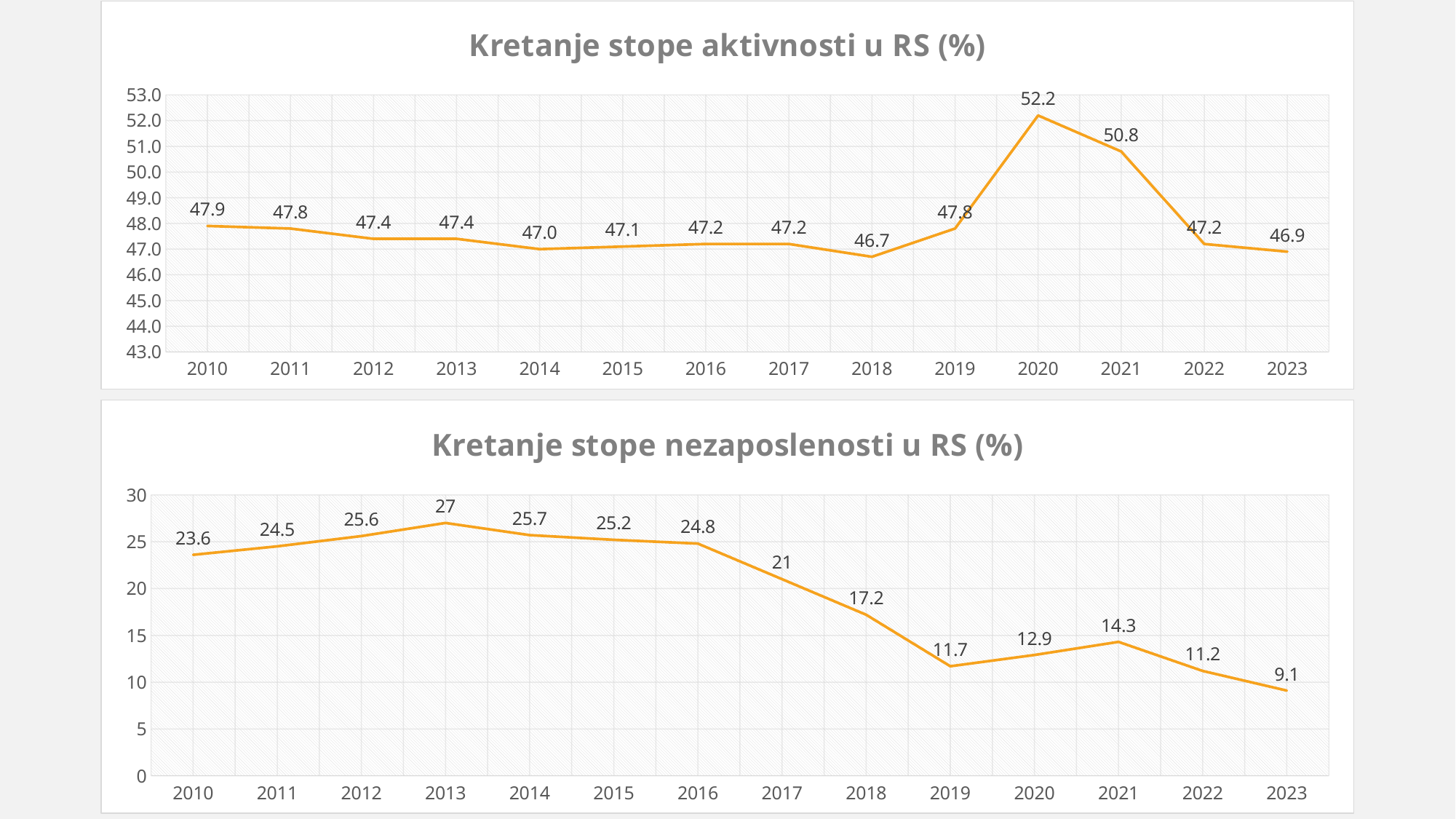
In the chart titled 'Kretanje stope nezaposlenosti u RS (%)', what is the value for 2018? 17.2 What kind of chart is the top chart, 'Kretanje stope aktivnosti u RS (%)'? line chart In the chart titled 'Kretanje stope aktivnosti u RS (%)', which year has the lowest value? 2018 What is the title of the bottom chart on the slide? Kretanje stope nezaposlenosti u RS (%) In the chart titled 'Kretanje stope nezaposlenosti u RS (%)', which year has the highest value? 2013 In the chart titled 'Kretanje stope nezaposlenosti u RS (%)', which year has the lowest value? 2023 In the chart titled 'Kretanje stope nezaposlenosti u RS (%)', is the value for 2021 larger or smaller than the value for 2019? larger In the chart titled 'Kretanje stope aktivnosti u RS (%)', what is the difference between the values for 2020 and 2021? 1.4 In the chart titled 'Kretanje stope aktivnosti u RS (%)', how many years are plotted? 14 In the chart titled 'Kretanje stope aktivnosti u RS (%)', what is the value for 2020? 52.2 In the chart titled 'Kretanje stope nezaposlenosti u RS (%)', what is the difference between the values for 2010 and 2023? 14.5 In the chart titled 'Kretanje stope nezaposlenosti u RS (%)', do the values generally rise or fall from 2016 to 2019? fall